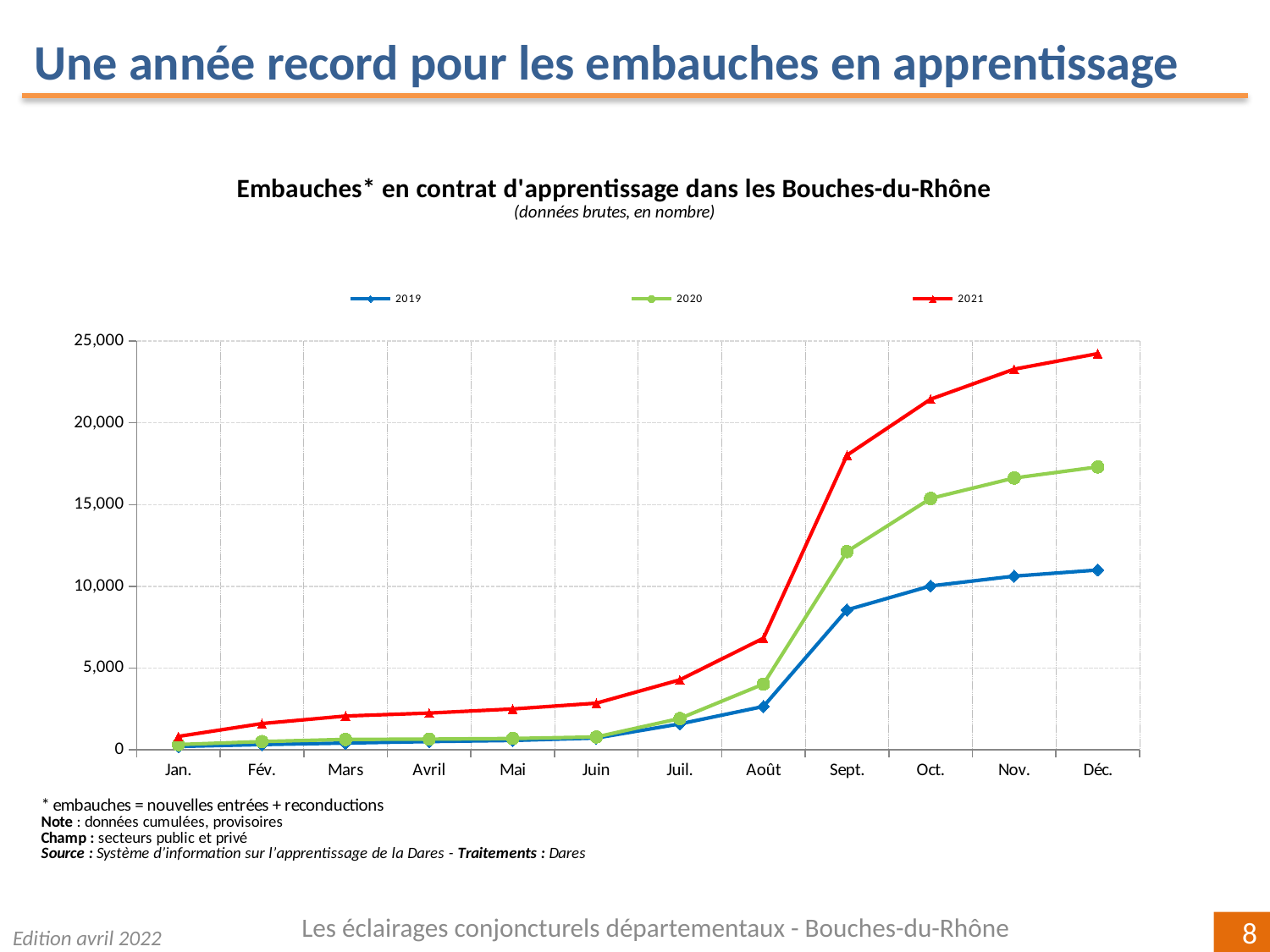
Is the value for 2021 in Sept. greater or less than 20,000? less Is the value for 2021 in Déc. greater or less than 20,000? greater Is the value for 2019 in Sept. greater or less than 10,000? less Which series has the highest value in Déc.? 2021 How many months are plotted along the x axis? 12 Which series has the lowest value in Déc.? 2019 Do the values for 2021 rise or fall from Jan. to Déc.? rise What kind of chart is shown on the slide? line chart Which is larger in Oct., the value for 2020 or the value for 2021? 2021 How many series does the legend list? 3 What is the title of the chart? Embauches* en contrat d'apprentissage dans les Bouches-du-Rhône